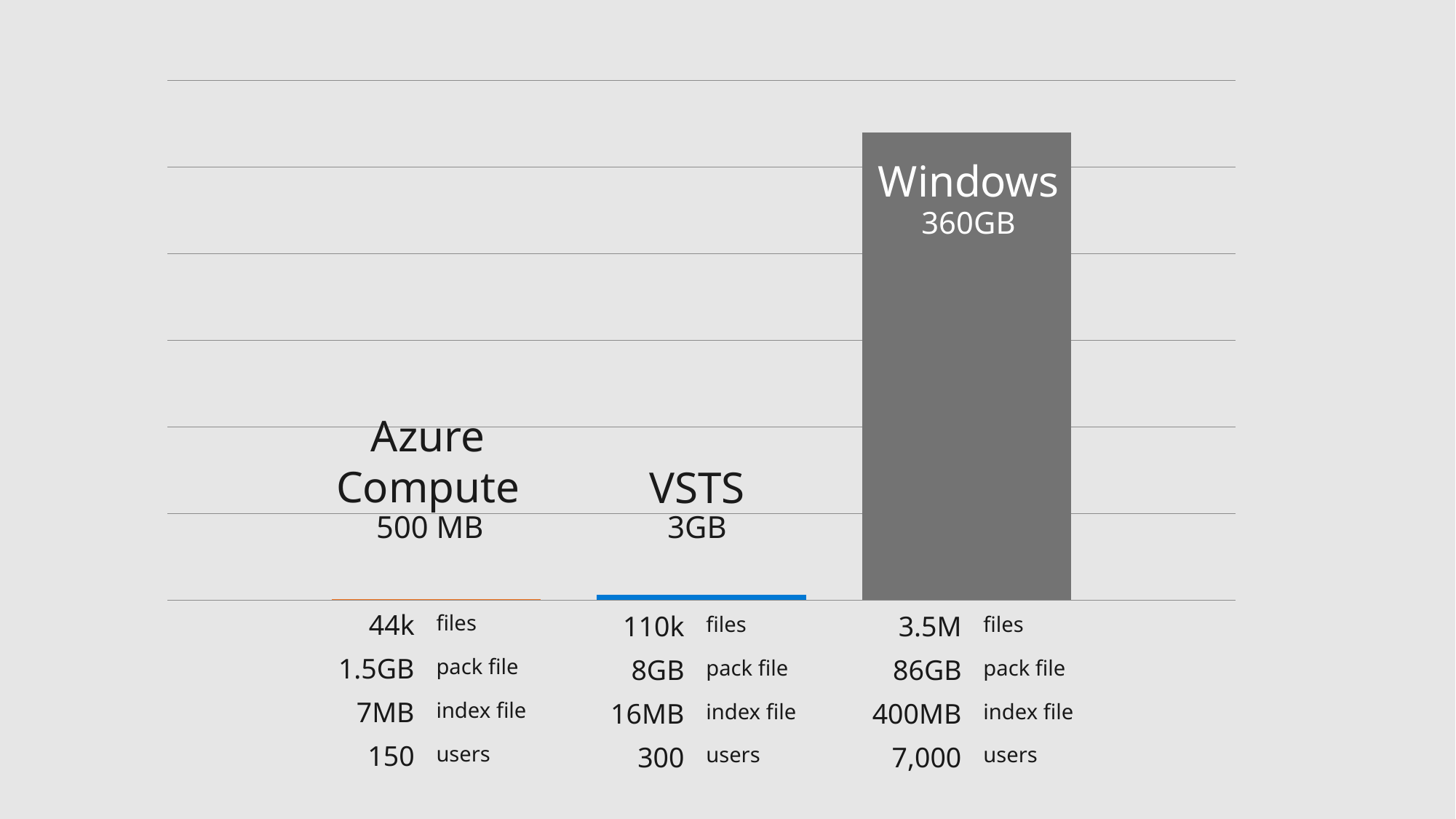
What is the pack file size listed under VSTS? 8GB What repository size is shown for VSTS? 3GB What kind of chart is shown on the slide? bar chart Which category has the smallest bar? Azure Compute How many users are listed under Windows? 7,000 Which category has the tallest bar? Windows Which is larger, the bar for VSTS or the bar for Azure Compute? VSTS How many files are listed under Azure Compute? 44k What is the difference in size between Windows and VSTS? 357GB What repository size is shown for Azure Compute? 500 MB How many categories (bars) does the chart show? 3 What repository size is shown for Windows? 360GB